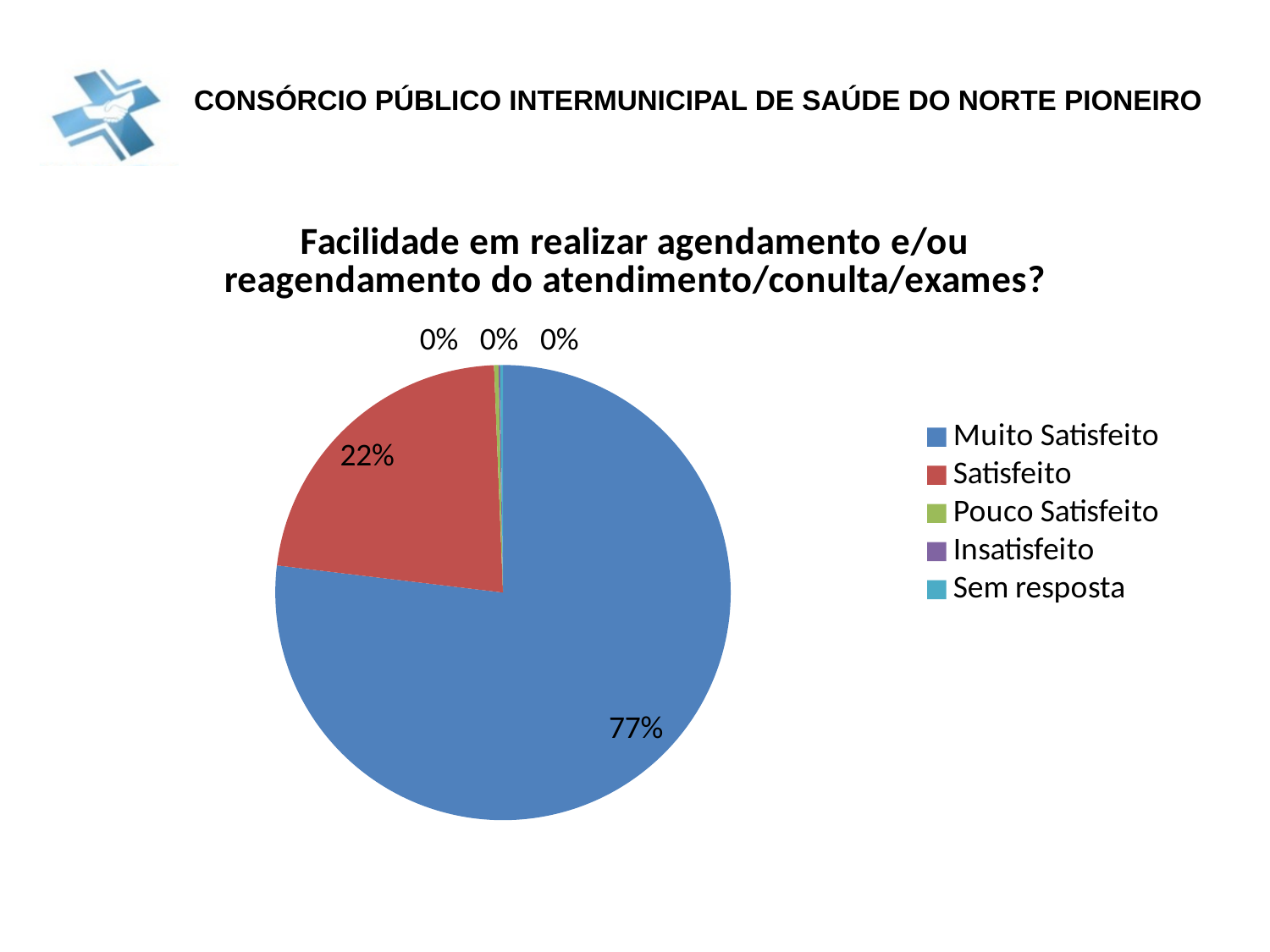
How many slices are labelled 0%? 3 What is the title of the chart? Facilidade em realizar agendamento e/ou reagendamento do atendimento/conulta/exames? What share of the pie does Muito Satisfeito have? 77% What share of the pie does Satisfeito have? 22% What colour is the Satisfeito slice? red Is the share for Muito Satisfeito greater or less than 50%? greater What type of chart is shown on the slide? pie chart Which is larger, the slice for Muito Satisfeito or the slice for Satisfeito? Muito Satisfeito How many categories does the legend list? 5 What is the difference in percentage points between the Muito Satisfeito and Satisfeito slices? 55 Which category has the largest slice of the pie? Muito Satisfeito